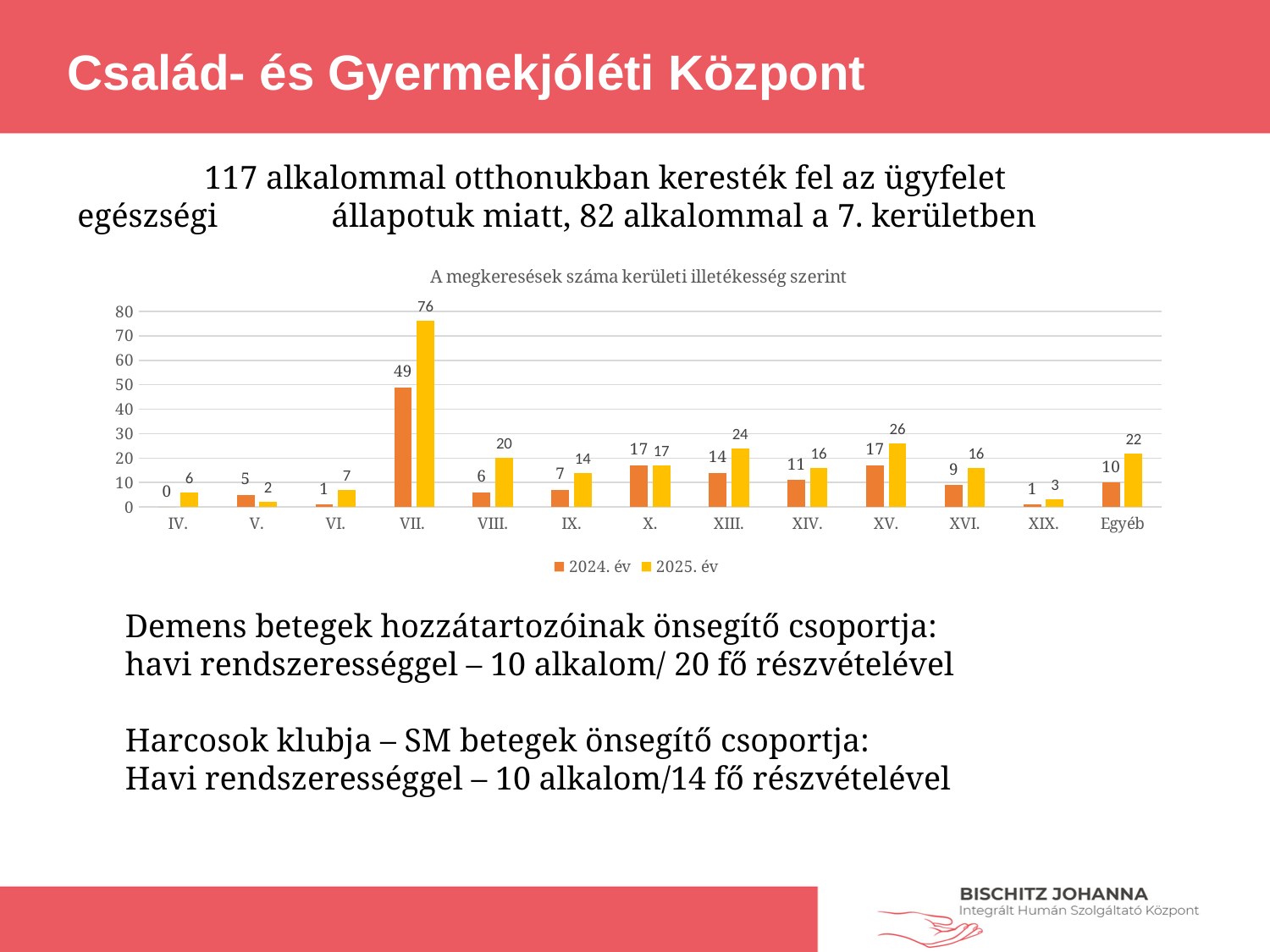
What is the value for XV. in the 2024. év series? 17 Is the value for VII. in the 2025. év series greater or less than 70? greater How many series does the legend list? 2 What is the value for VII. in the 2025. év series? 76 What is the value for Egyéb in the 2025. év series? 22 What is the difference between the 2025. év and 2024. év values for VII.? 27 Which category has the highest value in the 2024. év series? VII. Which is larger for XIII.: the 2024. év value or the 2025. év value? 2025. év How many categories are shown on the x axis? 13 What is the title of the chart? A megkeresések száma kerületi illetékesség szerint Which category has the lowest value in the 2025. év series? V. What kind of chart is shown on the slide? bar chart